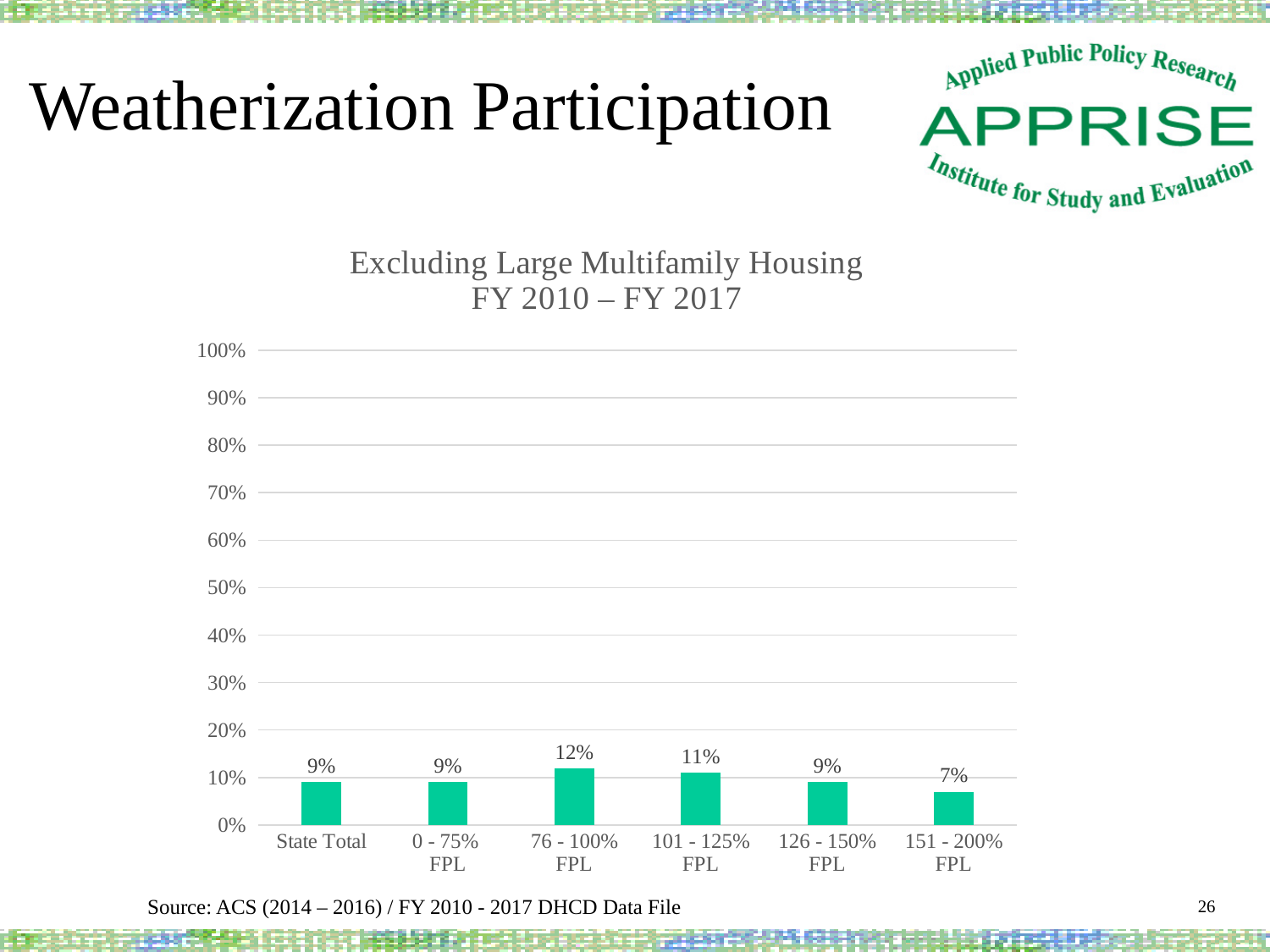
What is the difference between the participation rates of the 76 - 100% FPL group and the 151 - 200% FPL group? 5% What is the participation rate for the 76 - 100% FPL group? 12% What is the weatherization participation rate for the State Total? 9% Which category has the highest participation rate? 76 - 100% FPL What is the subtitle shown above the chart? Excluding Large Multifamily Housing FY 2010 – FY 2017 What is the participation rate for the 101 - 125% FPL group? 11% How many categories are shown on the x axis of the chart? 6 Which has a higher participation rate, the 101 - 125% FPL group or the 126 - 150% FPL group? 101 - 125% FPL Which category has the lowest participation rate? 151 - 200% FPL Is the value for the 76 - 100% FPL group greater or less than 10%? greater What kind of chart is shown on the slide? Bar chart What is the participation rate for the 151 - 200% FPL group? 7%